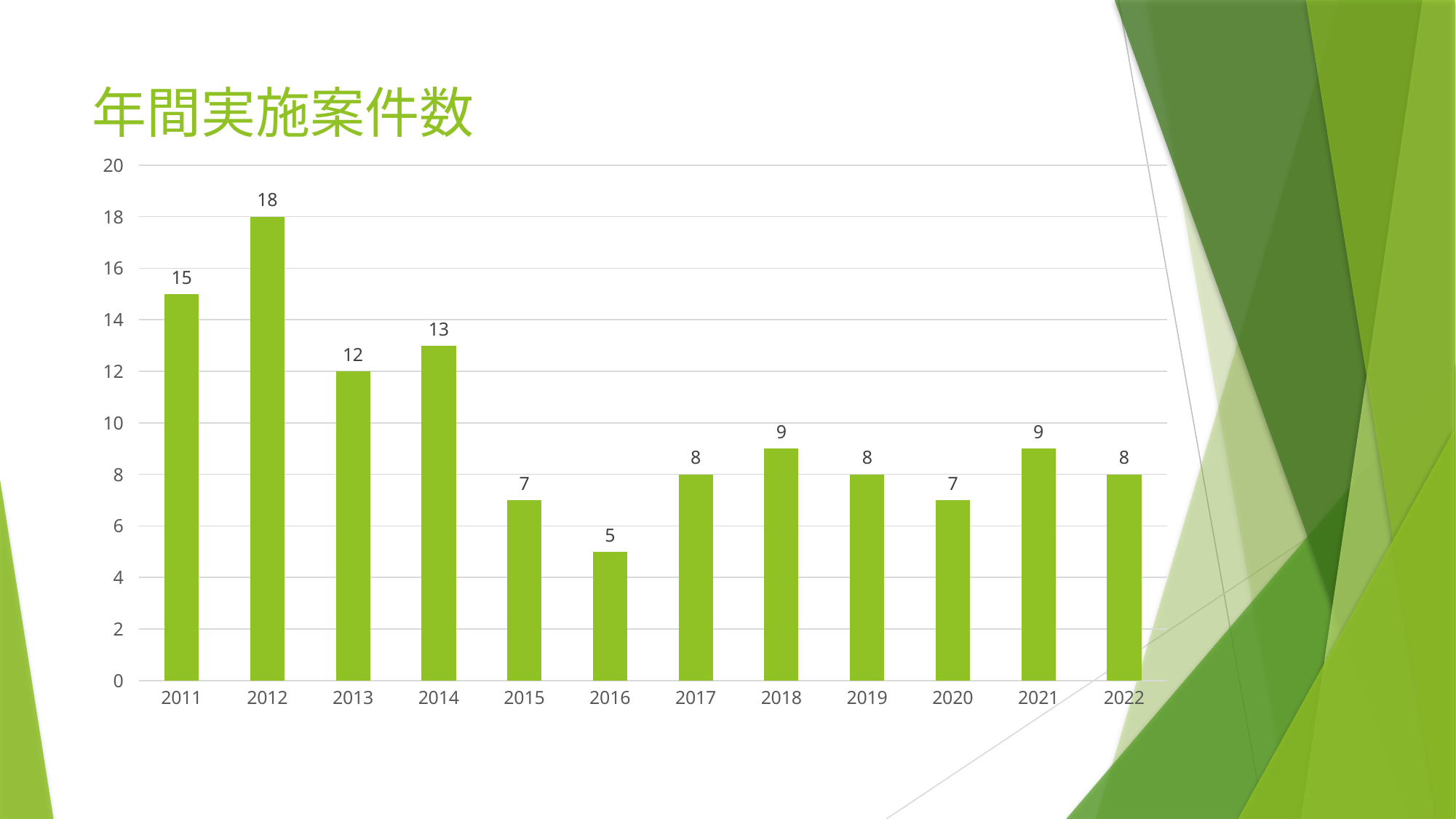
Which year has the highest value? 2012 What is the value for 2012? 18 What kind of chart is shown on the slide? bar chart What is the value for 2016? 5 How many years are shown on the x axis? 12 Which year has the lowest value? 2016 What is the value for 2022? 8 What is the title of the slide? 年間実施案件数 What is the difference between the values for 2011 and 2013? 3 What is the difference between the values for 2012 and 2016? 13 Which is larger, the value for 2014 or the value for 2018? 2014 Is the value for 2011 greater or less than 10? greater